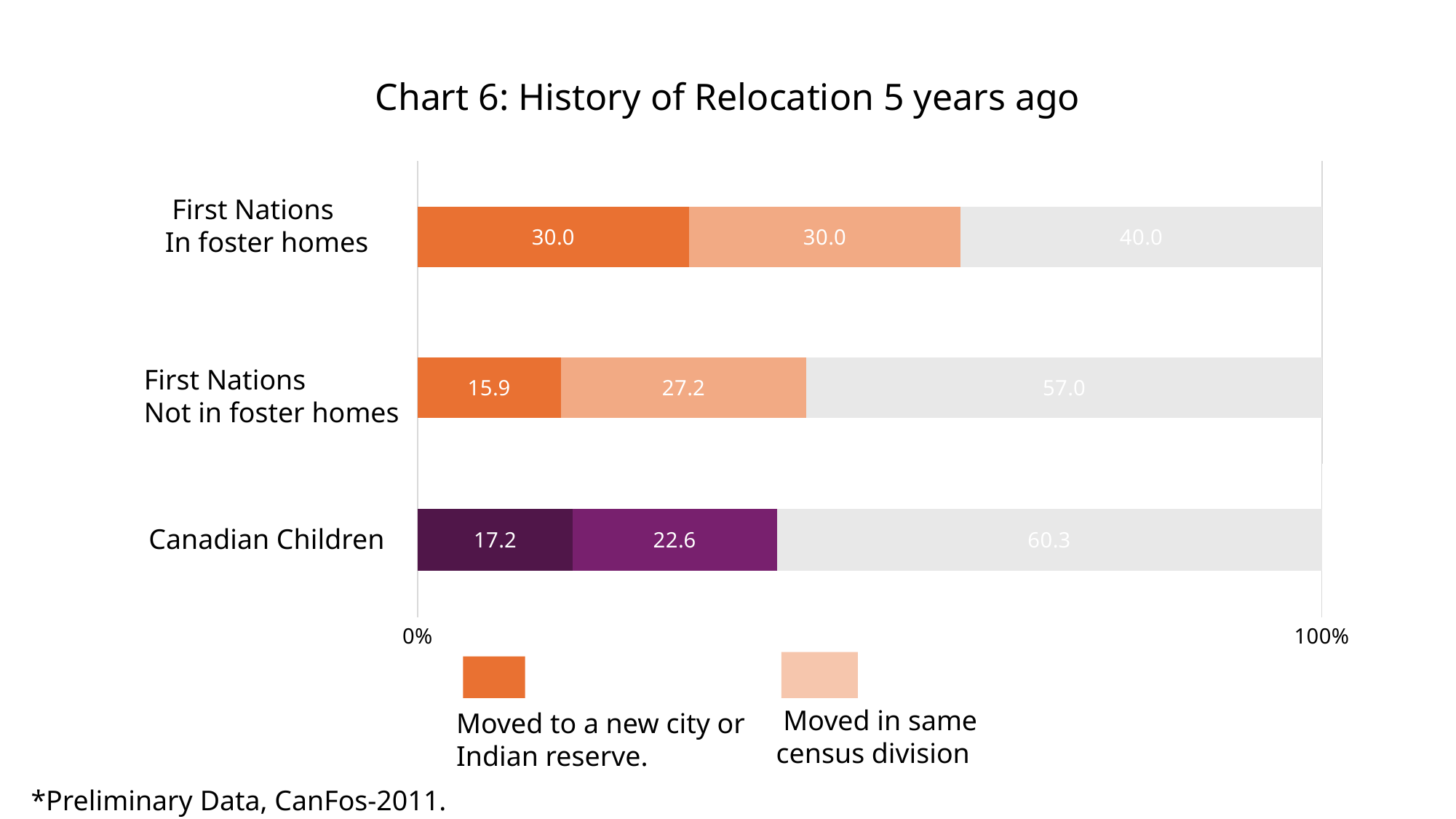
What is the value of the grey segment for Canadian Children? 60.3 What kind of chart is shown on the slide? Stacked bar chart What is the value for "Moved in same census division" for First Nations Not in foster homes? 27.2 What is the value for "Moved to a new city or Indian reserve" for First Nations In foster homes? 30.0 For "Moved in same census division", which is larger: First Nations Not in foster homes or Canadian Children? First Nations Not in foster homes What is the difference between the "Moved to a new city or Indian reserve" values for First Nations In foster homes and First Nations Not in foster homes? 14.1 What is the title of the chart? Chart 6: History of Relocation 5 years ago Which category has the lowest value for "Moved to a new city or Indian reserve"? First Nations Not in foster homes Which category has the highest value for "Moved to a new city or Indian reserve"? First Nations In foster homes What is the value for "Moved to a new city or Indian reserve" for Canadian Children? 17.2 How many series does the legend list? 2 How many categories are shown on the chart? 3